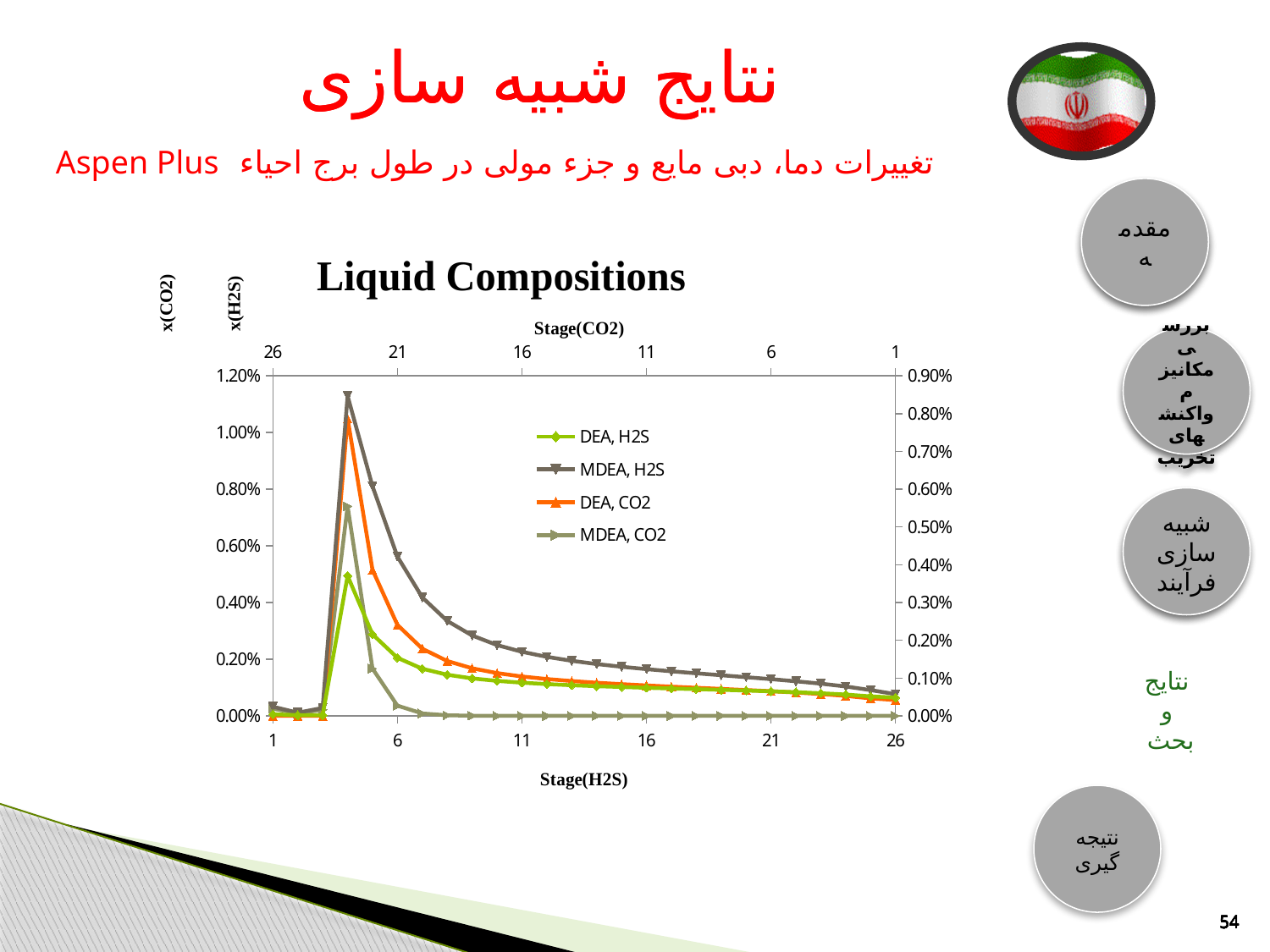
Is the value of the MDEA, CO2 series at stage 26 greater or less than 0.10% on the right axis? less What is the title of the chart? Liquid Compositions What is the label of the bottom horizontal axis of the chart? Stage(H2S) How many tick labels are shown on the bottom Stage(H2S) axis? 6 Is the peak value of the DEA, H2S series greater or less than 0.60% on the left axis? less Is the peak value of the MDEA, H2S series greater or less than 1.00% on the left axis? greater Which series peaks higher on the chart, DEA, H2S or MDEA, H2S? MDEA, H2S How many series does the chart legend list? 4 After reaching its peak, does the MDEA, H2S series rise or fall as the stage number increases toward 26? fall What kind of chart is shown on the slide? line chart What is the highest value shown on the left vertical axis of the chart? 1.20%